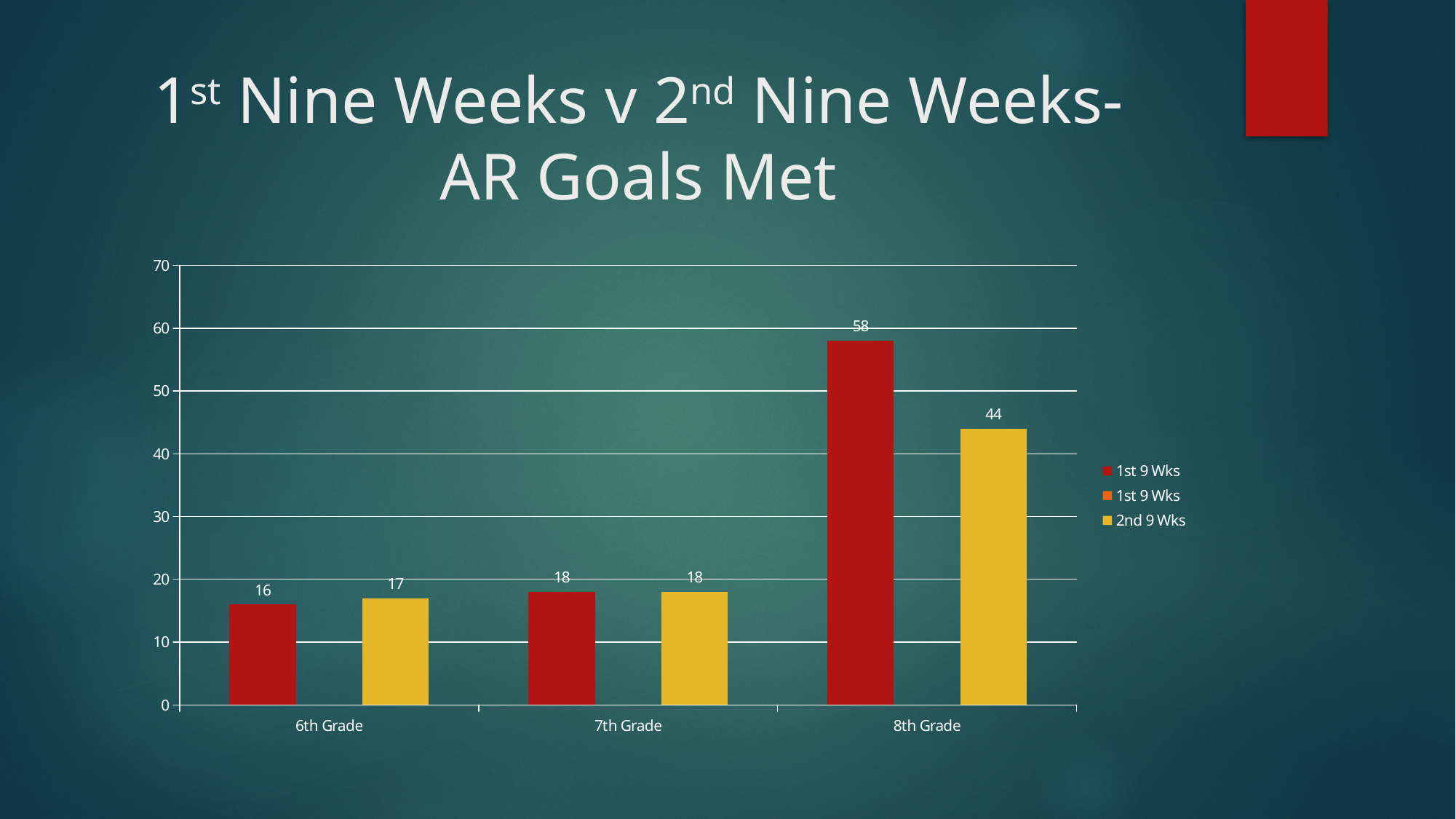
Which is larger for 8th Grade: the 1st 9 Wks value or the 2nd 9 Wks value? 1st 9 Wks What is the difference between the 1st 9 Wks and 2nd 9 Wks values for 8th Grade? 14 What is the value for 7th Grade in the 1st 9 Wks series? 18 What colour are the 2nd 9 Wks bars? Yellow What is the value for 8th Grade in the 1st 9 Wks series? 58 How many entries does the legend list? 3 What kind of chart is shown on the slide? Bar chart How many grade categories are shown on the x axis? 3 What is the value for 6th Grade in the 2nd 9 Wks series? 17 Which grade has the lowest value in the 1st 9 Wks series? 6th Grade Which grade has the highest value in the 2nd 9 Wks series? 8th Grade Is the 2nd 9 Wks value for 8th Grade greater or less than 40? greater